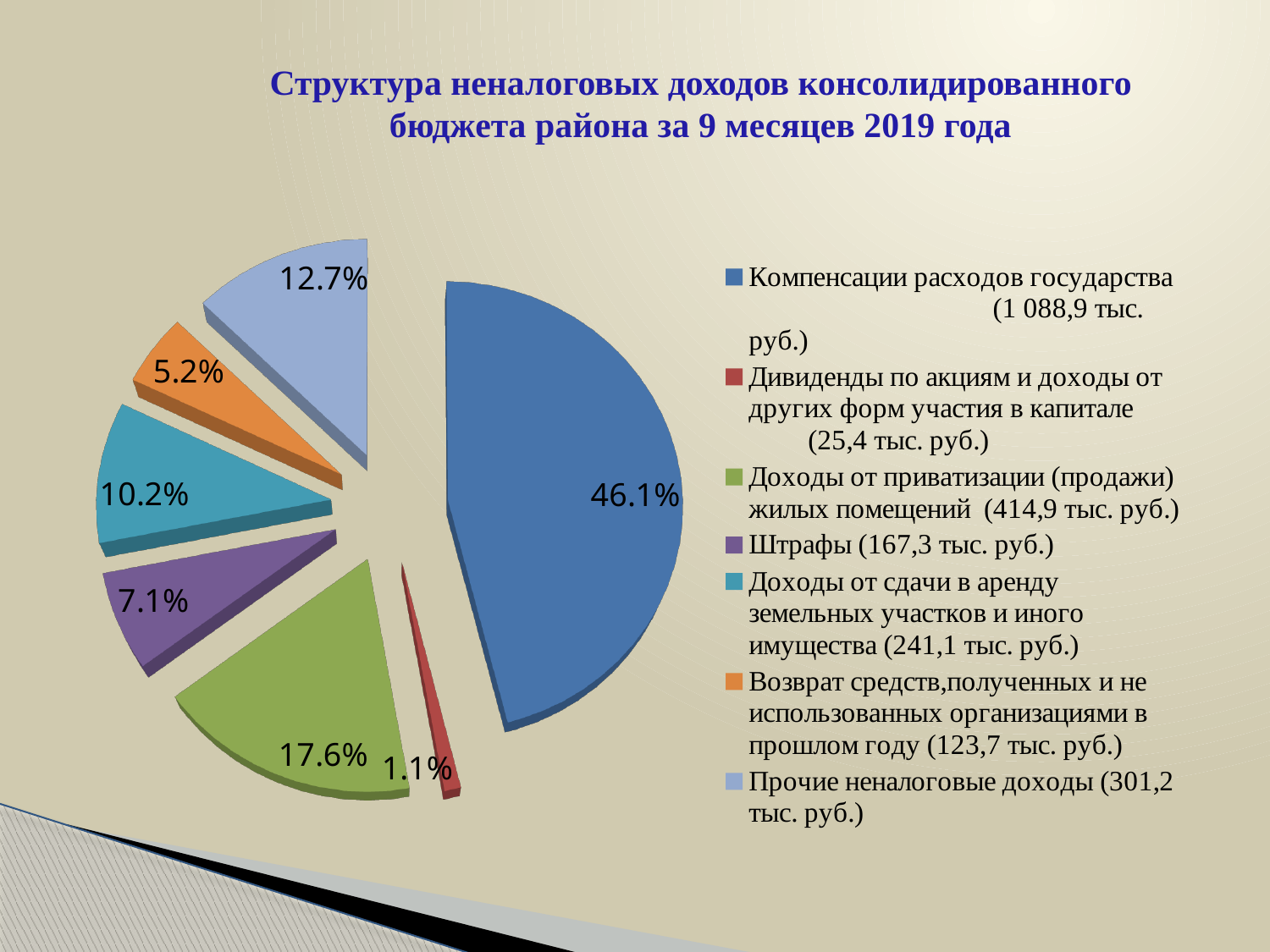
Which category has the smallest slice of the pie? Дивиденды по акциям и доходы от других форм участия в капитале What share of the pie does "Компенсации расходов государства" have? 46.1% What share of the pie does "Доходы от приватизации (продажи) жилых помещений" have? 17.6% How many slices does the pie chart have? 7 What is the difference in percentage points between the "Доходы от сдачи в аренду земельных участков и иного имущества" slice and the "Возврат средств" slice? 5.0% What share of the pie does "Прочие неналоговые доходы" have? 12.7% Which category has the largest slice of the pie? Компенсации расходов государства What is the title of the chart on the slide? Структура неналоговых доходов консолидированного бюджета района за 9 месяцев 2019 года What colour is the slice for "Штрафы"? Purple Which slice is larger: "Прочие неналоговые доходы" or "Доходы от сдачи в аренду земельных участков и иного имущества"? Прочие неналоговые доходы What kind of chart is shown on the slide? Pie chart